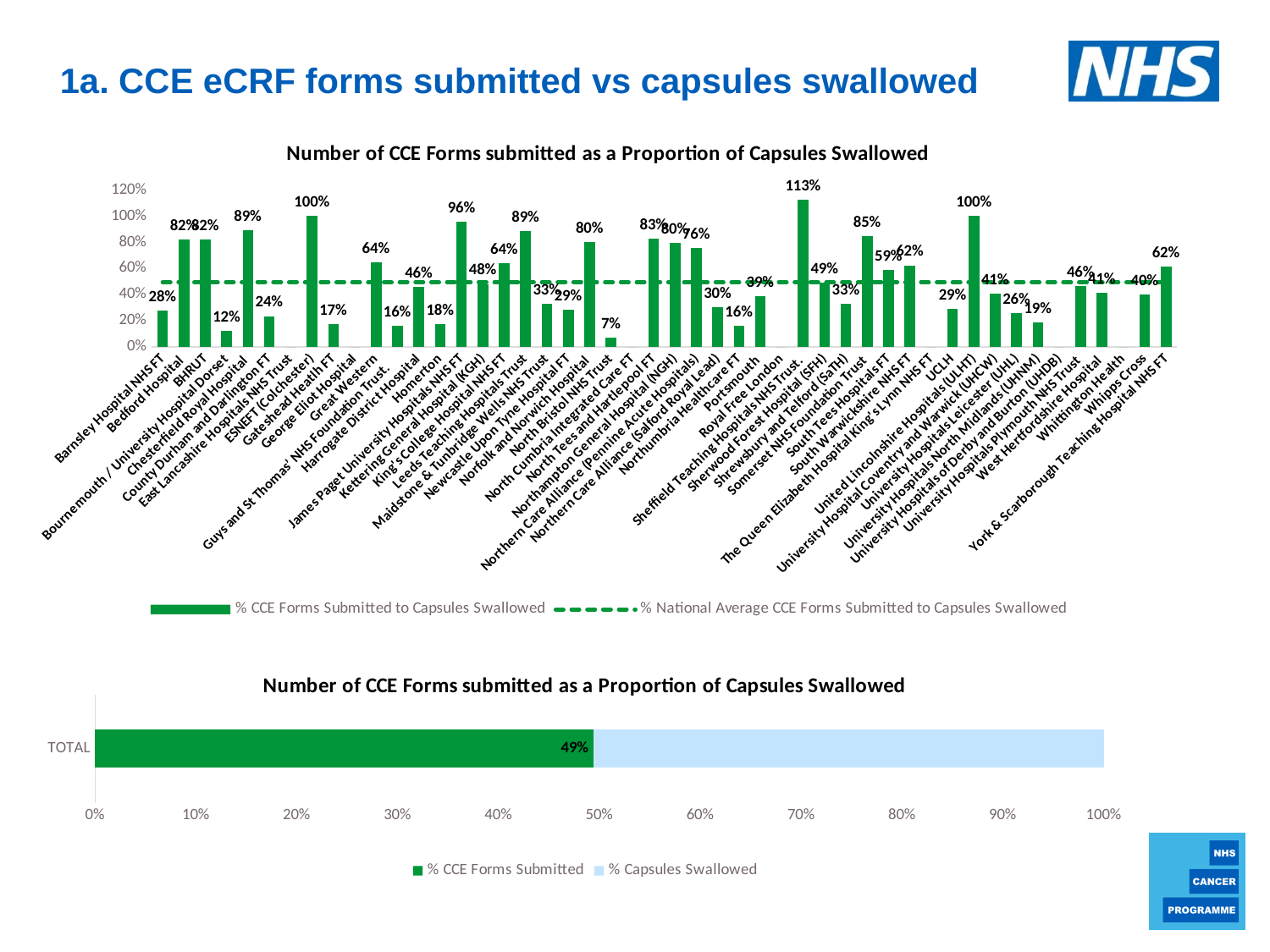
In the top chart, what is the value for Barnsley Hospital NHS FT? 28% In the bottom chart, how many series does the legend list? 2 What type of chart is the bottom chart? Bar chart In the top chart, what does the dashed line represent according to the legend? % National Average CCE Forms Submitted to Capsules Swallowed In the top chart, what is the lowest percentage value shown on any bar? 7% In the top chart, what is the difference between the highest bar value (113%) and the lowest bar value (7%)? 106 percentage points In the top chart, what is the highest percentage value shown on any bar? 113% In the top chart, how many series does the legend list? 2 In the top chart, how many bars have a value of 100% or more? 3 What type of chart is the top chart, 'Number of CCE Forms submitted as a Proportion of Capsules Swallowed'? Combination bar and line chart (bars with a dashed national-average line) In the bottom chart, what is the value of % CCE Forms Submitted for TOTAL? 49% In the bottom chart, is the value for % CCE Forms Submitted greater or less than 50%? less